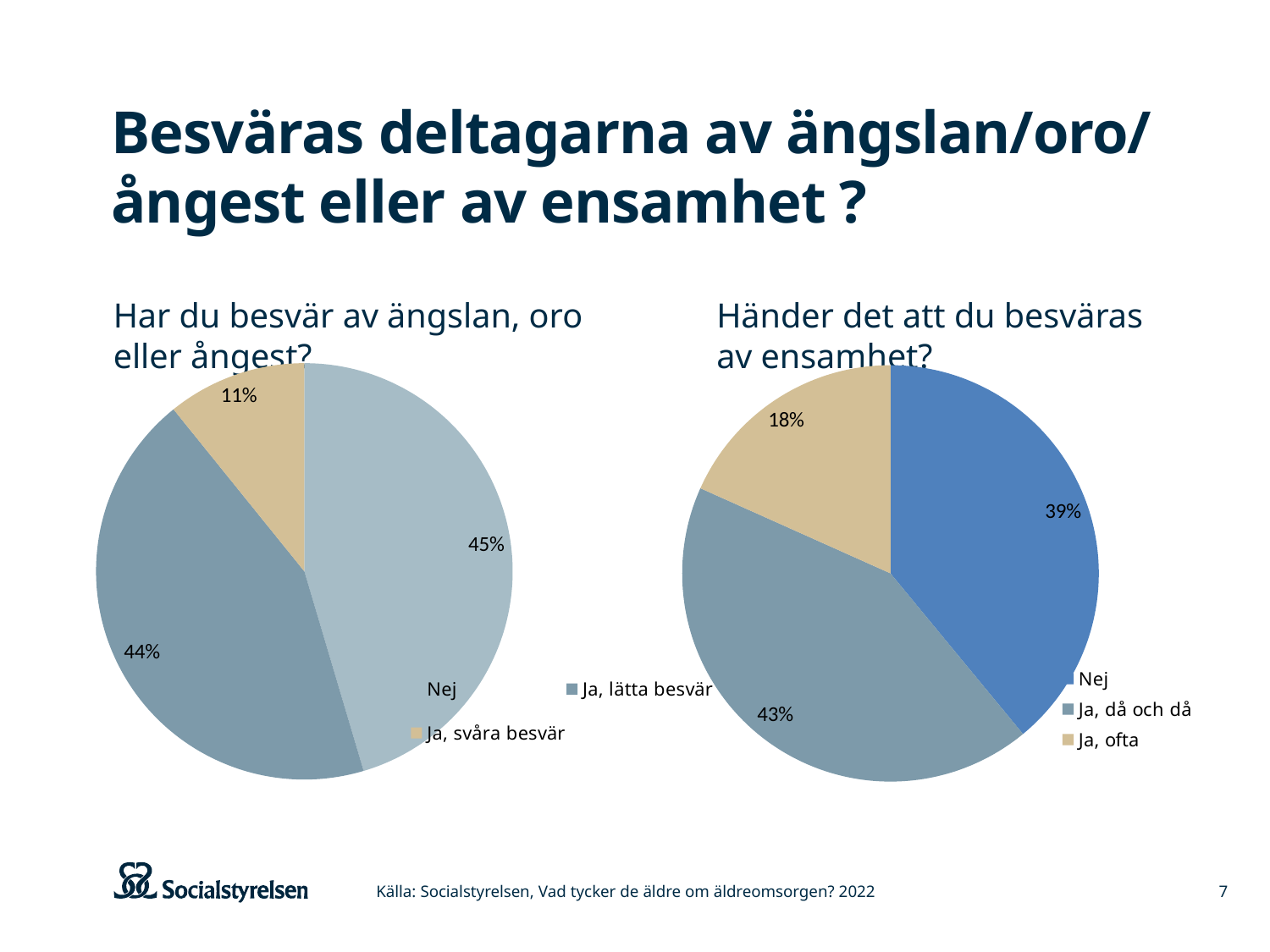
In the left chart (Har du besvär av ängslan, oro eller ångest?), what share answered "Ja, svåra besvär"? 11% In the right chart (Händer det att du besväras av ensamhet?), what share answered "Ja, då och då"? 43% In the right chart (Händer det att du besväras av ensamhet?), what is the difference in percentage points between "Ja, då och då" and "Ja, ofta"? 25 percentage points How many slices does the right chart (Händer det att du besväras av ensamhet?) have? 3 In the right chart (Händer det att du besväras av ensamhet?), which answer has the smallest slice? Ja, ofta What type of chart is used for the left chart (Har du besvär av ängslan, oro eller ångest?)? Pie chart In the left chart (Har du besvär av ängslan, oro eller ångest?), which is larger: "Nej" or "Ja, svåra besvär"? Nej In the left chart (Har du besvär av ängslan, oro eller ångest?), what share of respondents answered "Nej"? 45% In the right chart (Händer det att du besväras av ensamhet?), what share answered "Ja, ofta"? 18% In the right chart (Händer det att du besväras av ensamhet?), what share answered "Nej"? 39% In the left chart (Har du besvär av ängslan, oro eller ångest?), what share answered "Ja, lätta besvär"? 44% In the left chart (Har du besvär av ängslan, oro eller ångest?), which answer has the smallest slice? Ja, svåra besvär